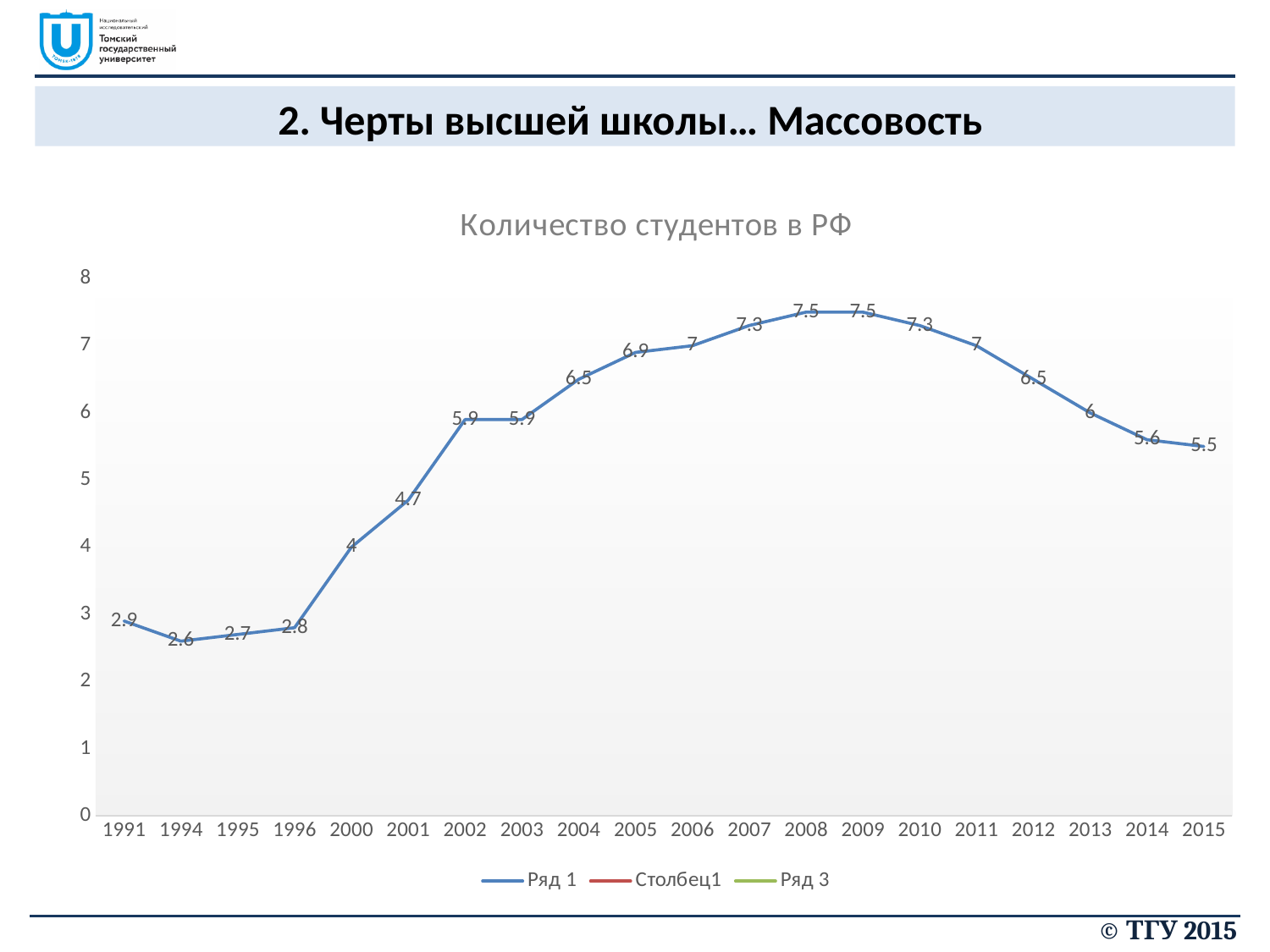
Which is larger, the value for 2001 or the value for 2013? 2013 What is the value for 1991? 2.9 What is the value for 2000? 4 How many years are plotted on the x axis? 20 How many series does the legend list? 3 Which year has the lowest value? 1994 Which is larger, the value for 2004 or the value for 2012? They are equal (6.5) What is the title of the chart? Количество студентов в РФ What is the difference between the values for 2008 and 1994? 4.9 What kind of chart is shown on the slide? line chart What is the value for 2015? 5.5 What is the highest value plotted on the chart? 7.5